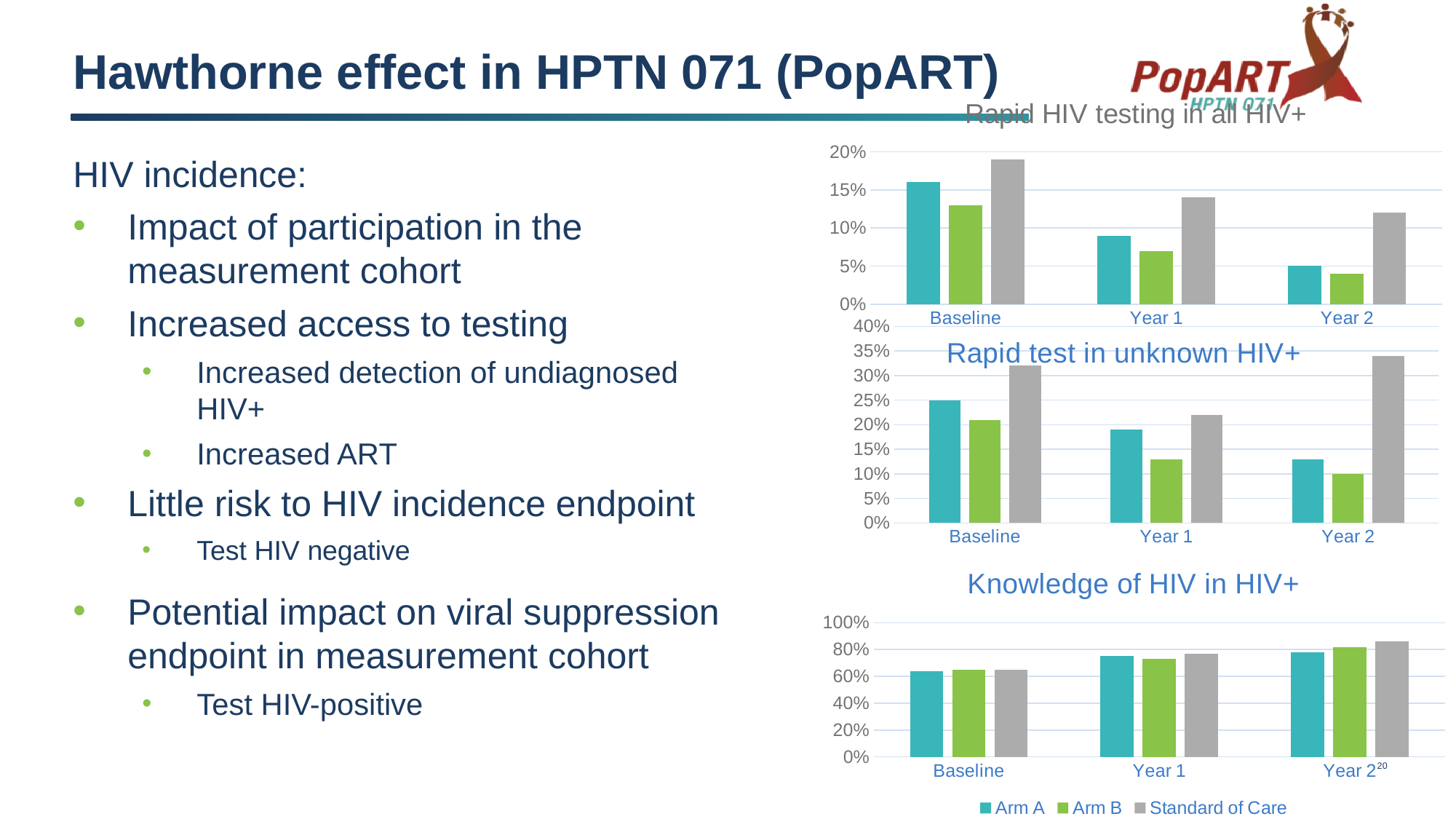
In the 'Rapid HIV testing in all HIV+' chart, which series has the highest value at Year 1? Standard of Care In the 'Rapid HIV testing in all HIV+' chart, is the Arm A value at Year 2 greater or less than 10%? less What kind of chart is the 'Rapid HIV testing in all HIV+' chart? bar chart In the 'Rapid test in unknown HIV+' chart, is the Standard of Care value at Year 2 greater or less than 30%? greater In the 'Knowledge of HIV in HIV+' chart, do the Standard of Care values rise or fall from Baseline to Year 2? rise In the 'Rapid test in unknown HIV+' chart, at which category is the Standard of Care value highest? Year 2 How many categories are shown on the x axis of the 'Knowledge of HIV in HIV+' chart? 3 In the 'Rapid HIV testing in all HIV+' chart, is the Standard of Care value at Baseline greater or less than 15%? greater In the 'Rapid HIV testing in all HIV+' chart, do the Arm A values rise or fall from Baseline to Year 2? fall How many series does the legend at the bottom of the slide list? 3 In the 'Rapid test in unknown HIV+' chart, which is larger at Baseline: Arm A or Arm B? Arm A